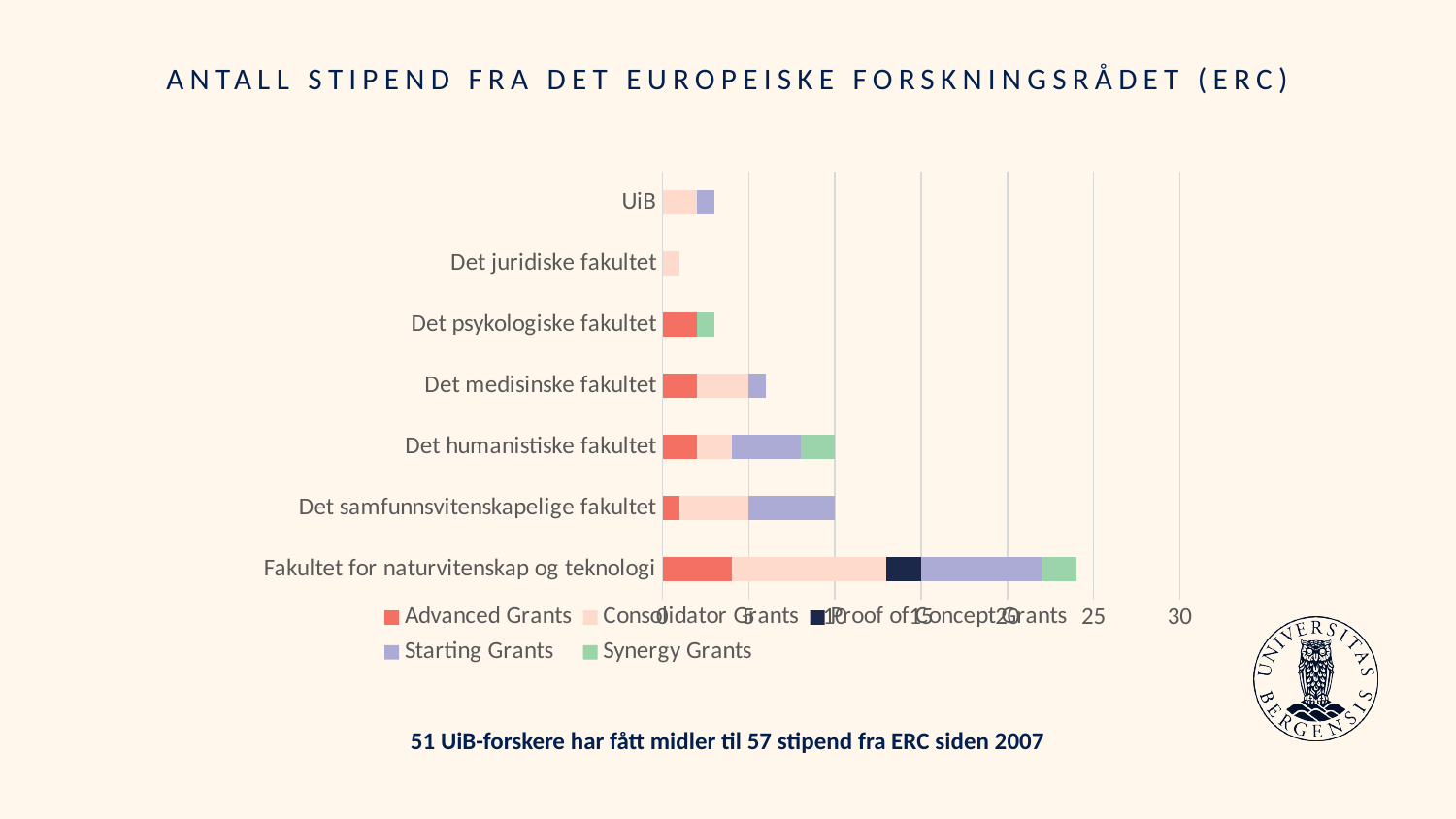
Is the total value for Fakultet for naturvitenskap og teknologi greater or less than 25? less Is the total value for Fakultet for naturvitenskap og teknologi greater or less than 20? greater Which has the larger total bar, Det humanistiske fakultet or Det juridiske fakultet? Det humanistiske fakultet Is the total value for Det psykologiske fakultet greater or less than 5? less Which category has the longest total bar? Fakultet for naturvitenskap og teknologi What kind of chart is shown on the slide? Stacked bar chart How many series does the chart legend list? 5 What is the title of the chart? ANTALL STIPEND FRA DET EUROPEISKE FORSKNINGSRÅDET (ERC) How many categories are plotted on the vertical axis of the chart? 7 Which series in the legend is shown in green? Synergy Grants Which category has the shortest total bar? Det juridiske fakultet